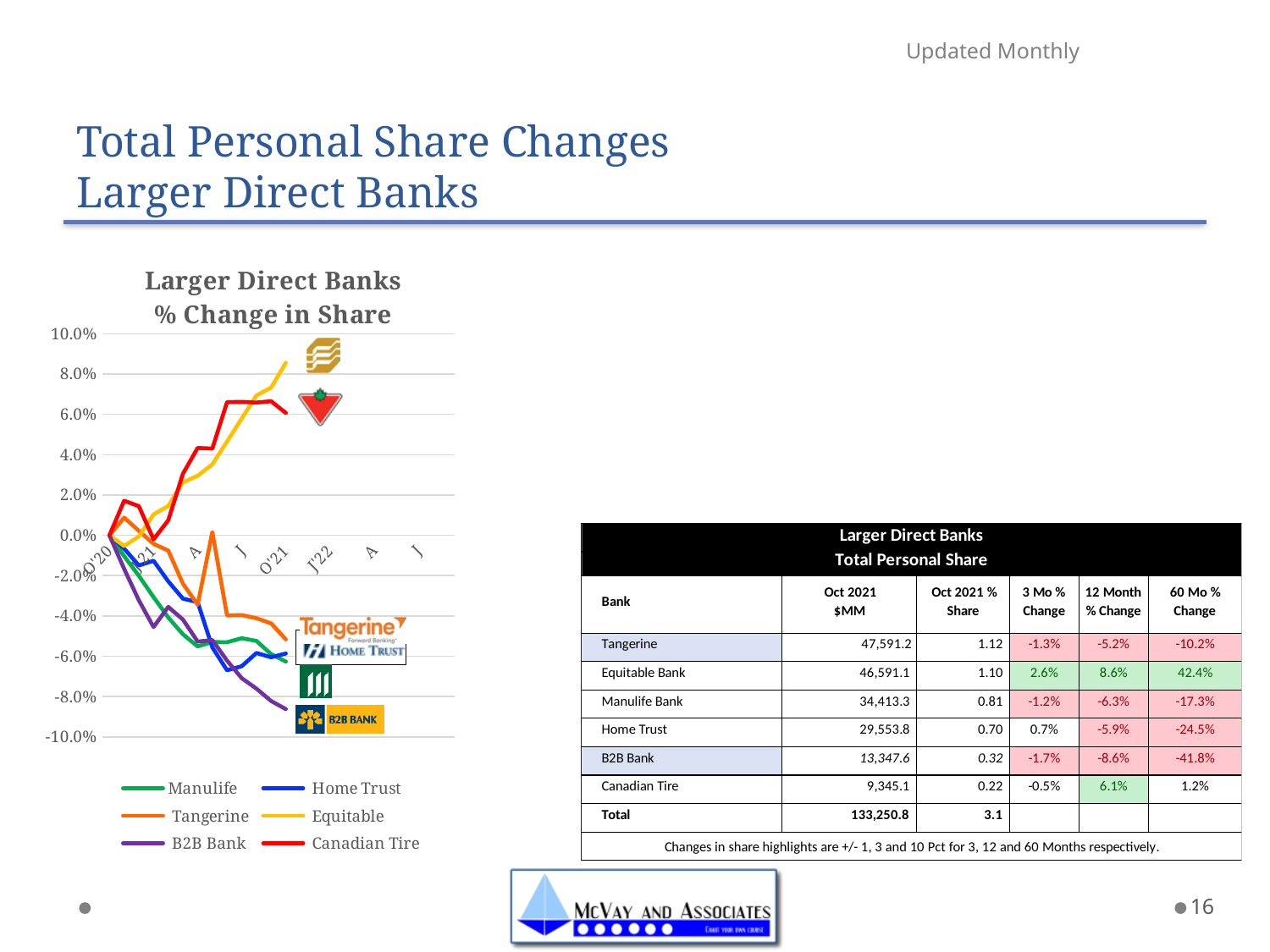
What is the title of the chart? Larger Direct Banks % Change in Share How many series does the chart legend list? 6 At the right end of the chart, which is lower, B2B Bank or Manulife? B2B Bank Which series has the lowest value at the right end of the chart? B2B Bank Is the final value for B2B Bank greater or less than -8.0%? less What kind of chart is shown on the slide? line chart Which series has the highest value at the right end of the chart? Equitable Is the final value for Tangerine greater or less than -4.0%? less At the right end of the chart, which is higher, Equitable or Canadian Tire? Equitable Does the B2B Bank line rise or fall from left to right across the chart? fall Is the final value for Equitable greater or less than 8.0%? greater Does the Equitable line rise or fall from left to right across the chart? rise